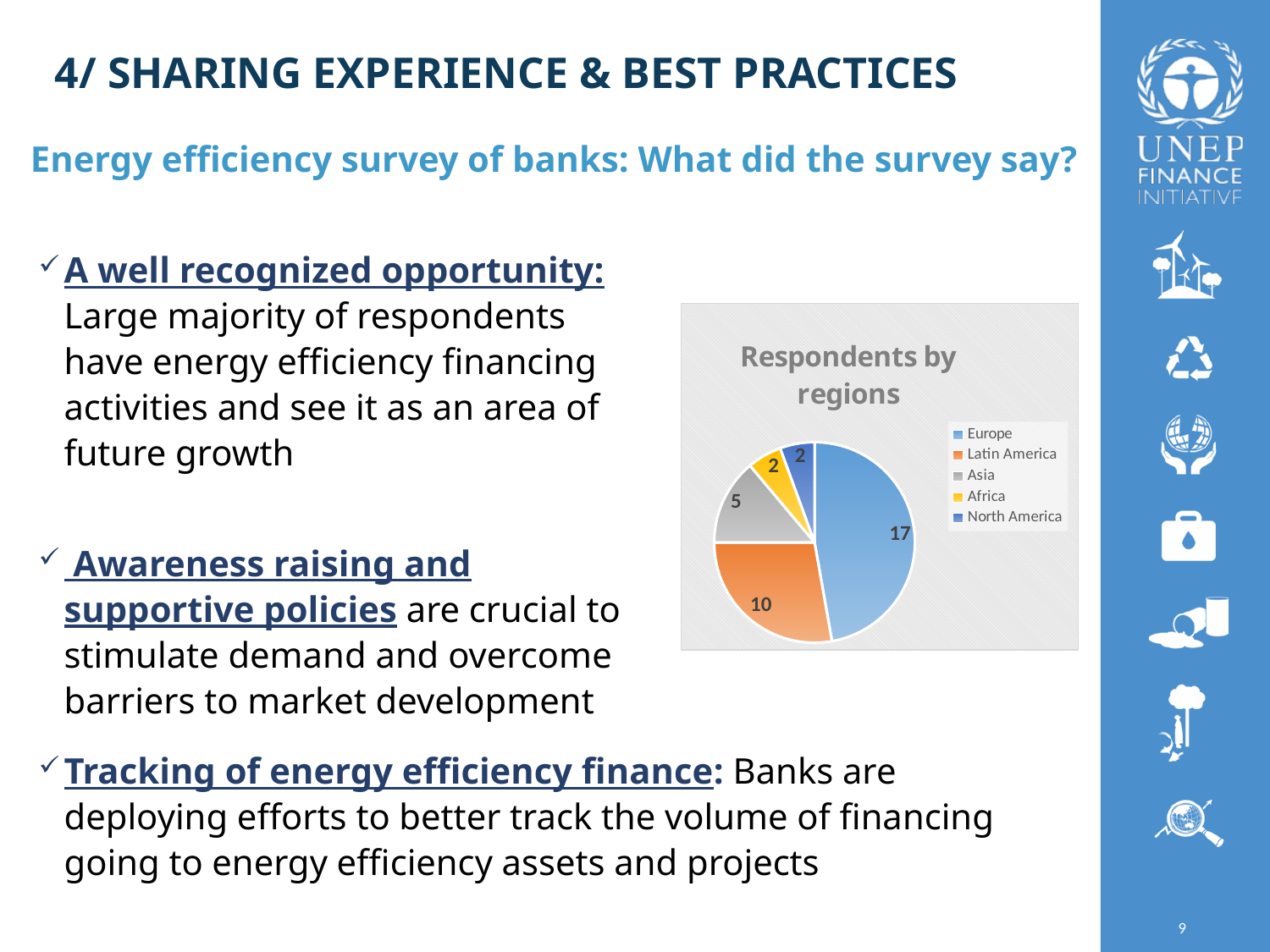
What is the difference between the number of respondents from Europe and from Latin America? 7 How many respondents are from Latin America? 10 How many respondents are from Africa? 2 What is the total number of respondents across all regions in the pie chart? 36 Which region has more respondents, Asia or Latin America? Latin America What type of chart is shown on the slide? Pie chart How many respondents are from Europe? 17 How many regions does the legend of the pie chart list? 5 How many respondents are from Asia? 5 Which region has the largest number of respondents? Europe Which regions have the fewest respondents? Africa and North America What is the title of the chart? Respondents by regions